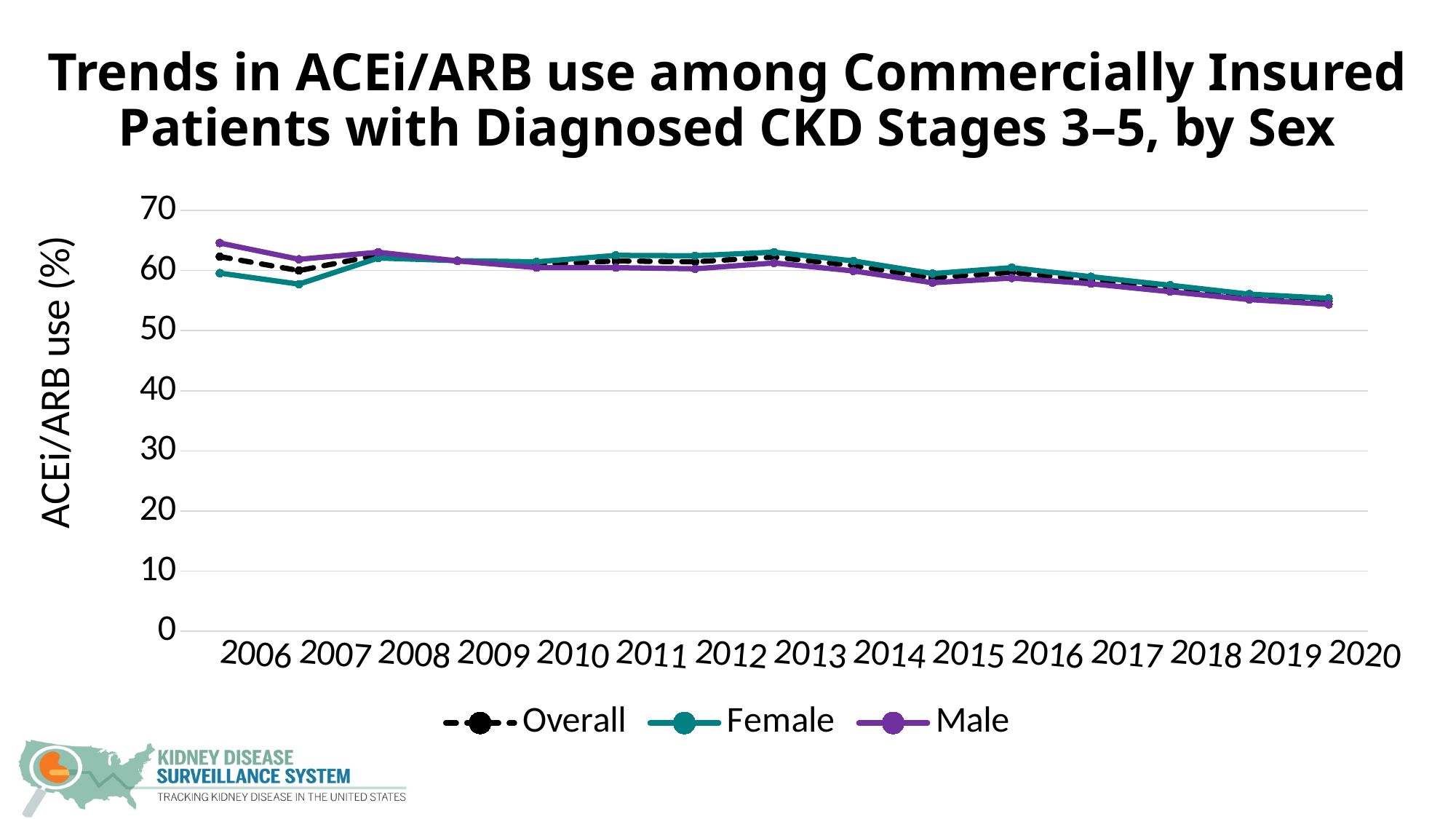
Overall, do the values rise or fall from 2006 to 2020? fall In 2007, which is higher, the Male value or the Female value? Male What is the y-axis label of the chart? ACEi/ARB use (%) Is the Male value in 2020 greater or less than 50? greater Which series is drawn with a dashed line? Overall In 2006, which is higher, the Male value or the Female value? Male What kind of chart is shown on the slide? line chart How many years are plotted along the x axis? 15 Is the Male value in 2006 greater or less than 60? greater How many series does the legend list? 3 Is the Female value in 2007 greater or less than 60? less In which year is the Male value highest? 2006